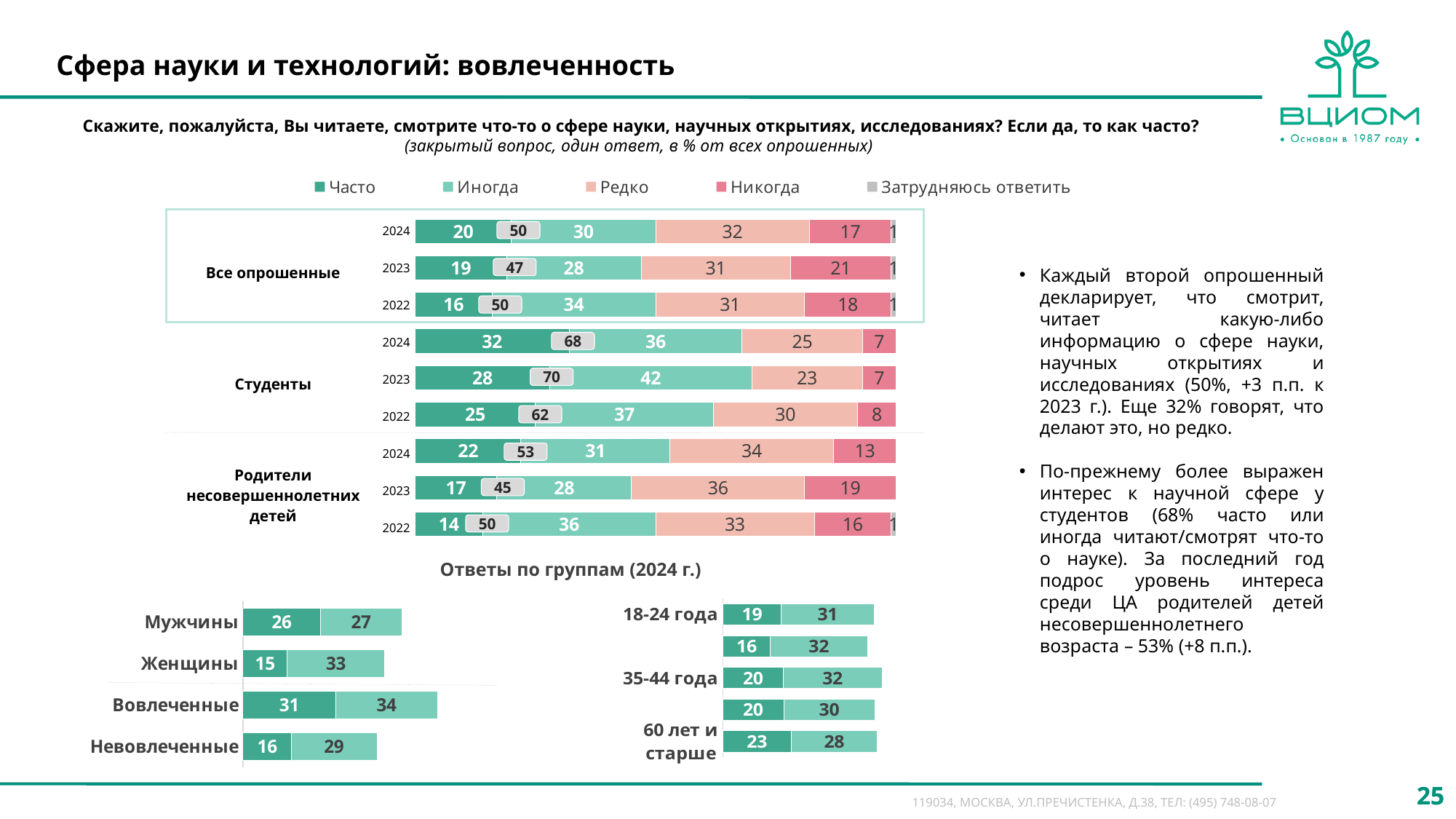
What kind of chart is the top chart on the slide? Stacked bar chart In the bottom-right chart «Ответы по группам (2024 г.)», what is the «Иногда» value for «60 лет и старше»? 28 In the bottom-left chart «Ответы по группам (2024 г.)», what is the total of the «Часто» and «Иногда» values for «Женщины»? 48 In the top stacked bar chart, for «Все опрошенные», is the «Никогда» value larger in 2023 or in 2024? 2023 In the top stacked bar chart, what is the value of «Редко» for «Родители несовершеннолетних детей» in 2024? 34 In the top stacked bar chart, what is the difference between the «Часто» value for «Студенты» in 2024 and the «Часто» value for «Все опрошенные» in 2024? 12 In the bottom-left chart «Ответы по группам (2024 г.)», which category has the highest «Часто» value? Вовлеченные In the bottom-left chart «Ответы по группам (2024 г.)», what is the «Часто» value for «Мужчины»? 26 In the top stacked bar chart, how does the «Часто» value for «Студенты» change from 2022 to 2024? It rises In the top stacked bar chart, what is the value of «Иногда» for «Студенты» in 2023? 42 In the top stacked bar chart, what is the value of «Часто» for «Все опрошенные» in 2024? 20 How many series does the legend of the top stacked bar chart list? 5